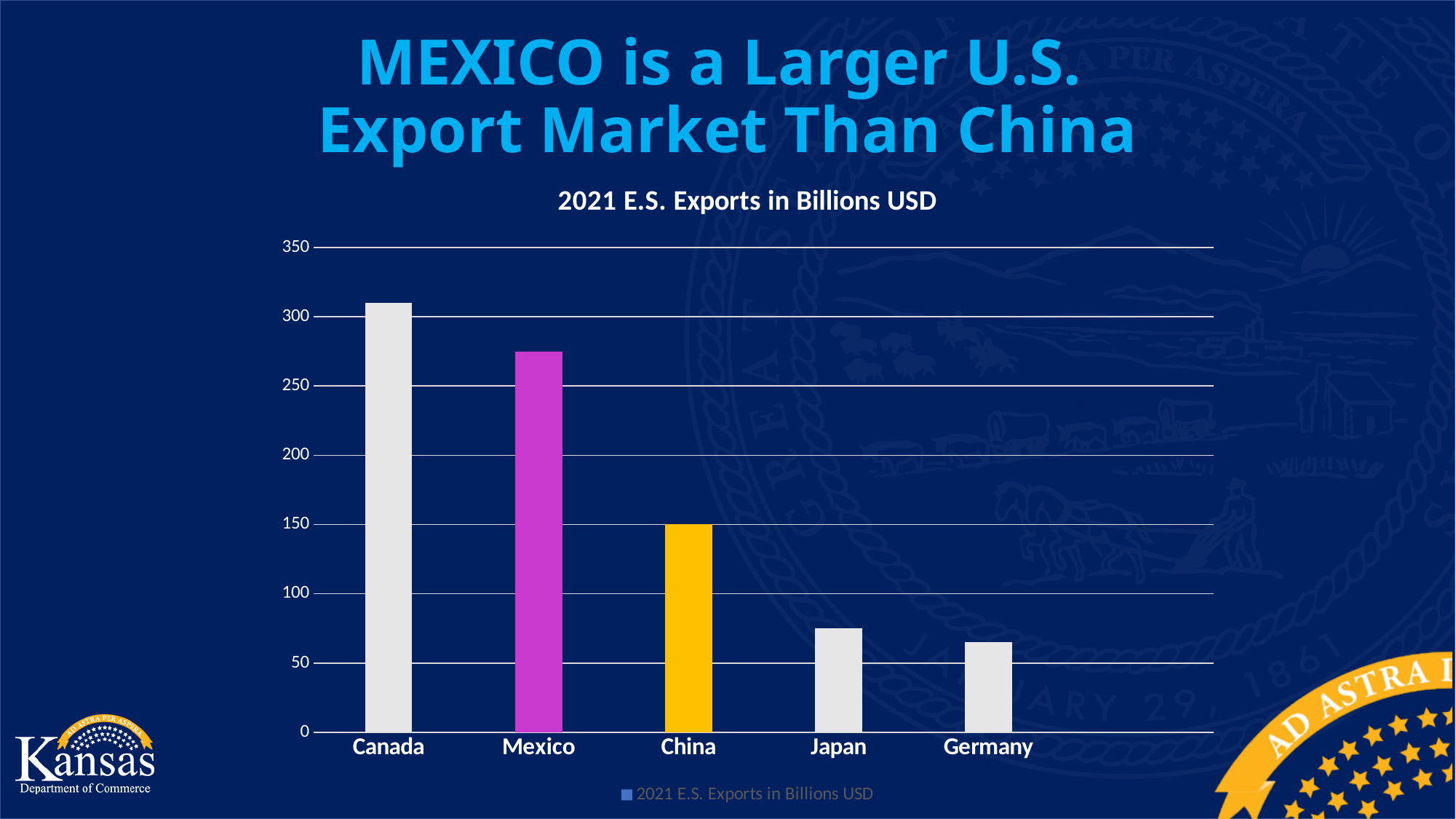
How many series does the chart legend list? 1 What type of chart is shown on the slide? bar chart Which country has the highest 2021 U.S. exports value in the chart? Canada What is the 2021 U.S. exports value for China in billions USD? 150 Is the value for Mexico greater or less than 250? greater Which has the larger value, Mexico or China? Mexico How many countries are shown on the x axis of the chart? 5 Is the value for Japan greater or less than 100? less Do the values rise or fall from Canada to Germany along the x axis? fall Which country has the lowest 2021 U.S. exports value in the chart? Germany Is the value for Germany greater or less than 50? greater